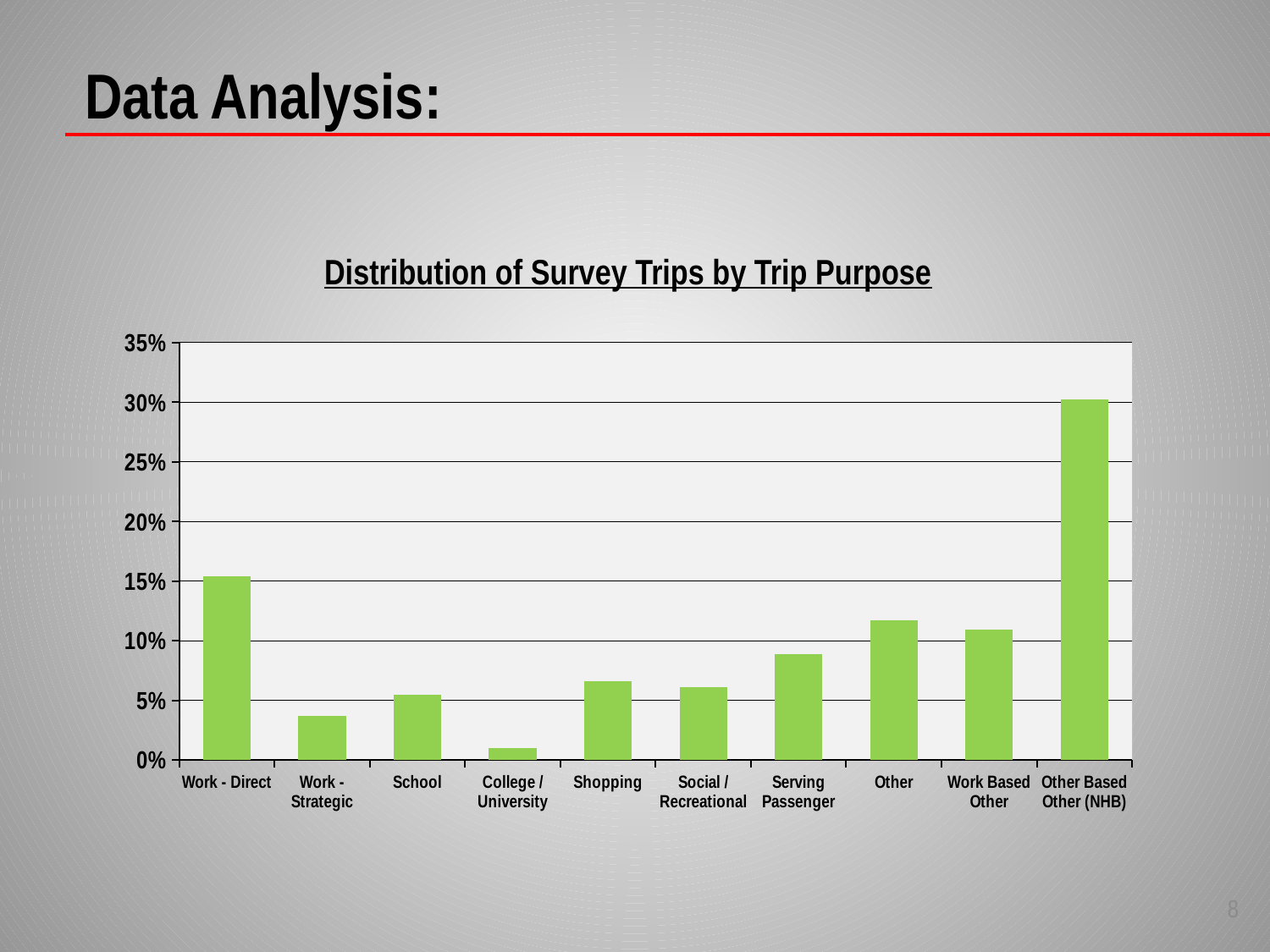
What kind of chart is shown on the slide? bar chart What is the title of the chart? Distribution of Survey Trips by Trip Purpose Is the value for Serving Passenger greater or less than 10%? less Which trip purpose has the highest share of survey trips? Other Based Other (NHB) Which is larger, the value for Work - Direct or the value for Other? Work - Direct Is the value for Work - Strategic greater or less than 5%? less Which trip purpose has the lowest share of survey trips? College / University How many trip purpose categories are shown on the x axis? 10 Which is larger, the value for School or the value for Serving Passenger? Serving Passenger What colour are the bars in the chart? green